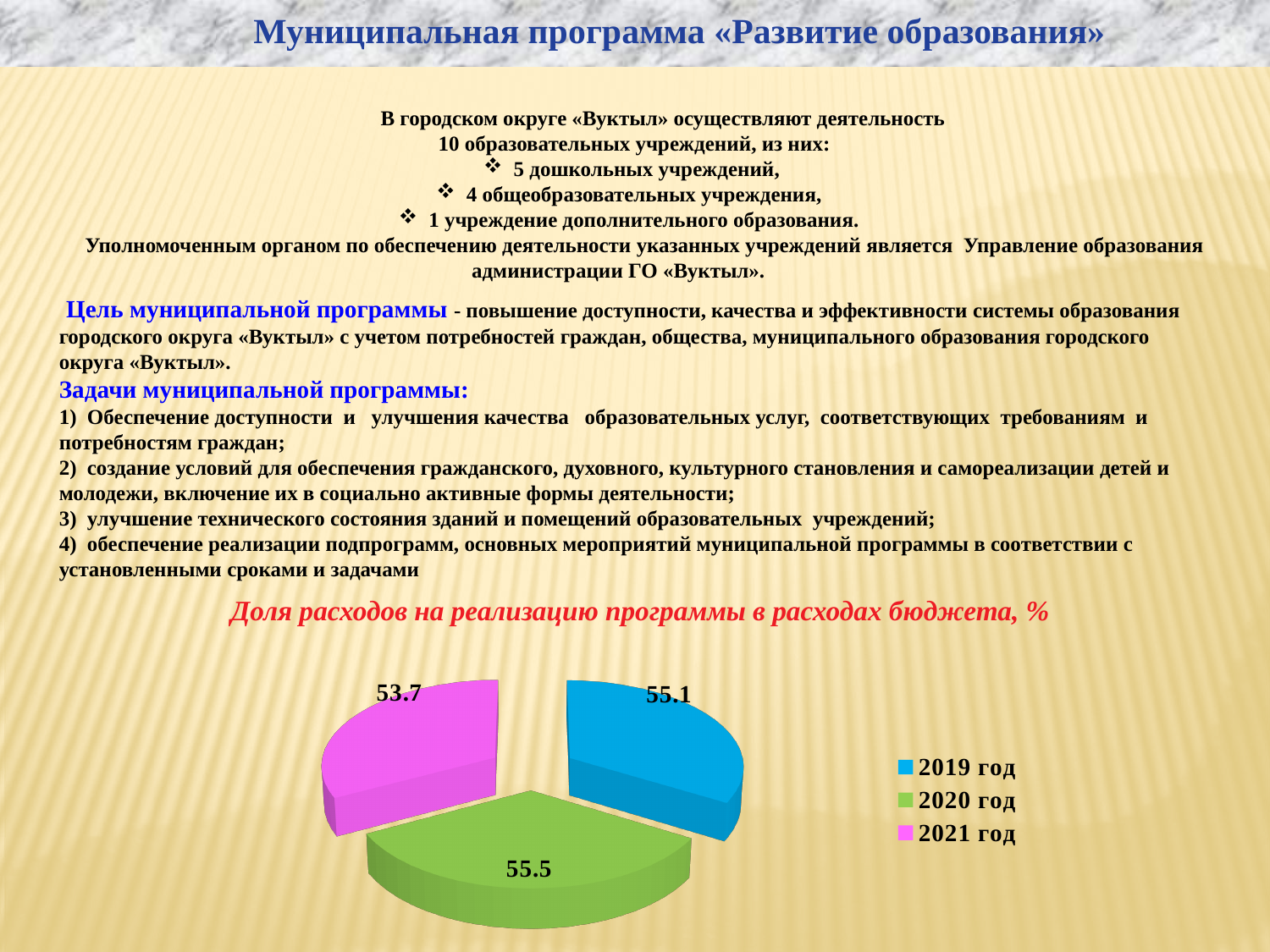
What type of chart is shown on the slide? Pie chart What is the difference between the values for 2020 год and 2021 год? 1.8 Which year has the highest value in the pie chart? 2020 год What value is shown for 2019 год in the pie chart? 55.1 What value is shown for 2021 год in the pie chart? 53.7 Which year has the lowest value in the pie chart? 2021 год What is the difference between the values for 2019 год and 2021 год? 1.4 Which is larger, the value for 2019 год or the value for 2021 год? 2019 год How many entries does the chart legend list? 3 How many slices does the pie chart have? 3 What is the title of the chart on the slide? Доля расходов на реализацию программы в расходах бюджета, % What value is shown for 2020 год in the pie chart? 55.5